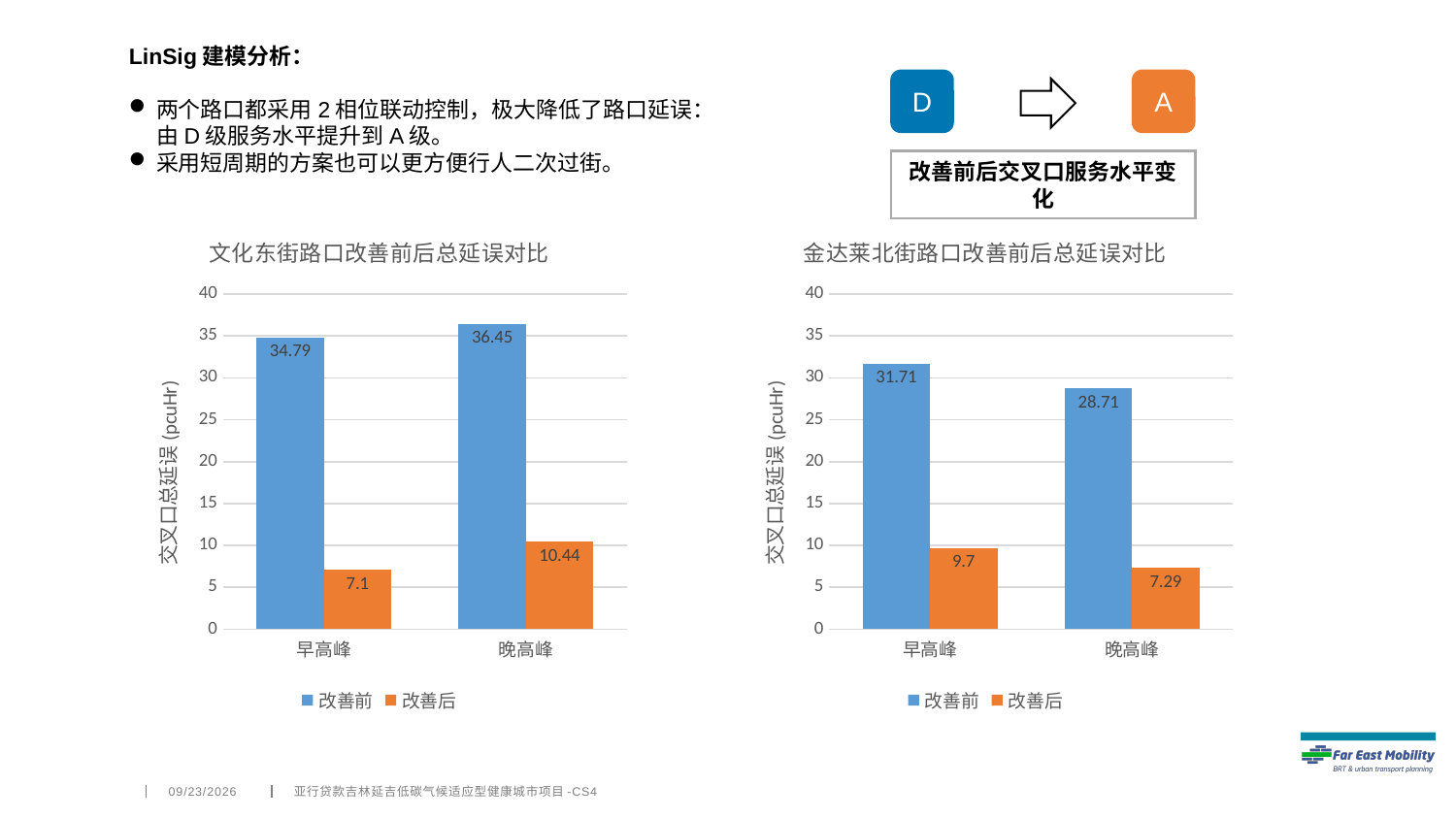
In the chart titled 文化东街路口改善前后总延误对比, what is the 改善前 value for 早高峰? 34.79 What is the y-axis label of the chart titled 文化东街路口改善前后总延误对比? 交叉口总延误 (pcuHr) In the chart titled 金达莱北街路口改善前后总延误对比, which period has the lowest 改善后 value? 晚高峰 How many series does the legend list in the chart titled 文化东街路口改善前后总延误对比? 2 What kind of chart is the chart titled 金达莱北街路口改善前后总延误对比? bar chart In the chart titled 金达莱北街路口改善前后总延误对比, what is the 改善后 value for 早高峰? 9.7 In the chart titled 文化东街路口改善前后总延误对比, what is the 改善后 value for 晚高峰? 10.44 In the chart titled 金达莱北街路口改善前后总延误对比, is the 改善前 value for 早高峰 greater or less than 30? greater In the chart titled 金达莱北街路口改善前后总延误对比, what is the difference between the 改善前 and 改善后 values for 晚高峰? 21.42 In the chart titled 金达莱北街路口改善前后总延误对比, what is the 改善前 value for 晚高峰? 28.71 In the chart titled 文化东街路口改善前后总延误对比, which period has the higher 改善前 value, 早高峰 or 晚高峰? 晚高峰 In the chart titled 文化东街路口改善前后总延误对比, what is the difference between the 改善前 and 改善后 values for 早高峰? 27.69